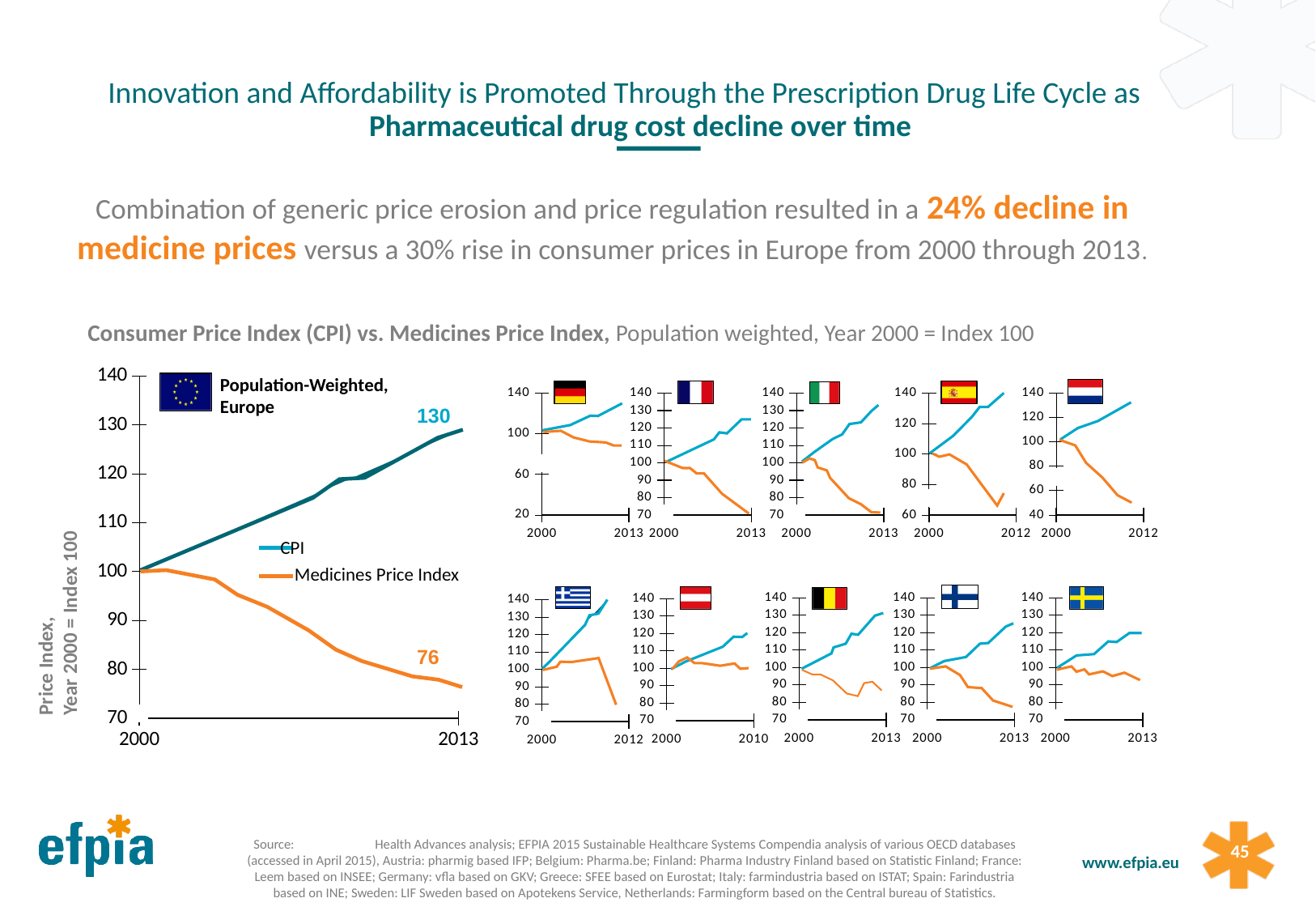
What are the two legend entries in the Population-Weighted, Europe chart? CPI and Medicines Price Index In the Population-Weighted, Europe chart, what is the value of the Medicines Price Index in 2013? 76 In the Population-Weighted, Europe chart, does the CPI line rise or fall from 2000 to 2013? rises How many series does the legend of the Population-Weighted, Europe chart list? 2 In the Population-Weighted, Europe chart, what is the value of the CPI line in 2013? 130 What kind of chart is the Population-Weighted, Europe chart? line chart In the Population-Weighted, Europe chart, is the CPI value in 2013 greater or less than 120? greater In the Population-Weighted, Europe chart, what is the difference between the CPI and the Medicines Price Index in 2013? 54 In the Population-Weighted, Europe chart, does the Medicines Price Index rise or fall from 2000 to 2013? falls In the Population-Weighted, Europe chart, which series is higher in 2013, CPI or Medicines Price Index? CPI In the Population-Weighted, Europe chart, at what index value do both series start in 2000? 100 How many small country charts are shown to the right of the Population-Weighted, Europe chart? 10